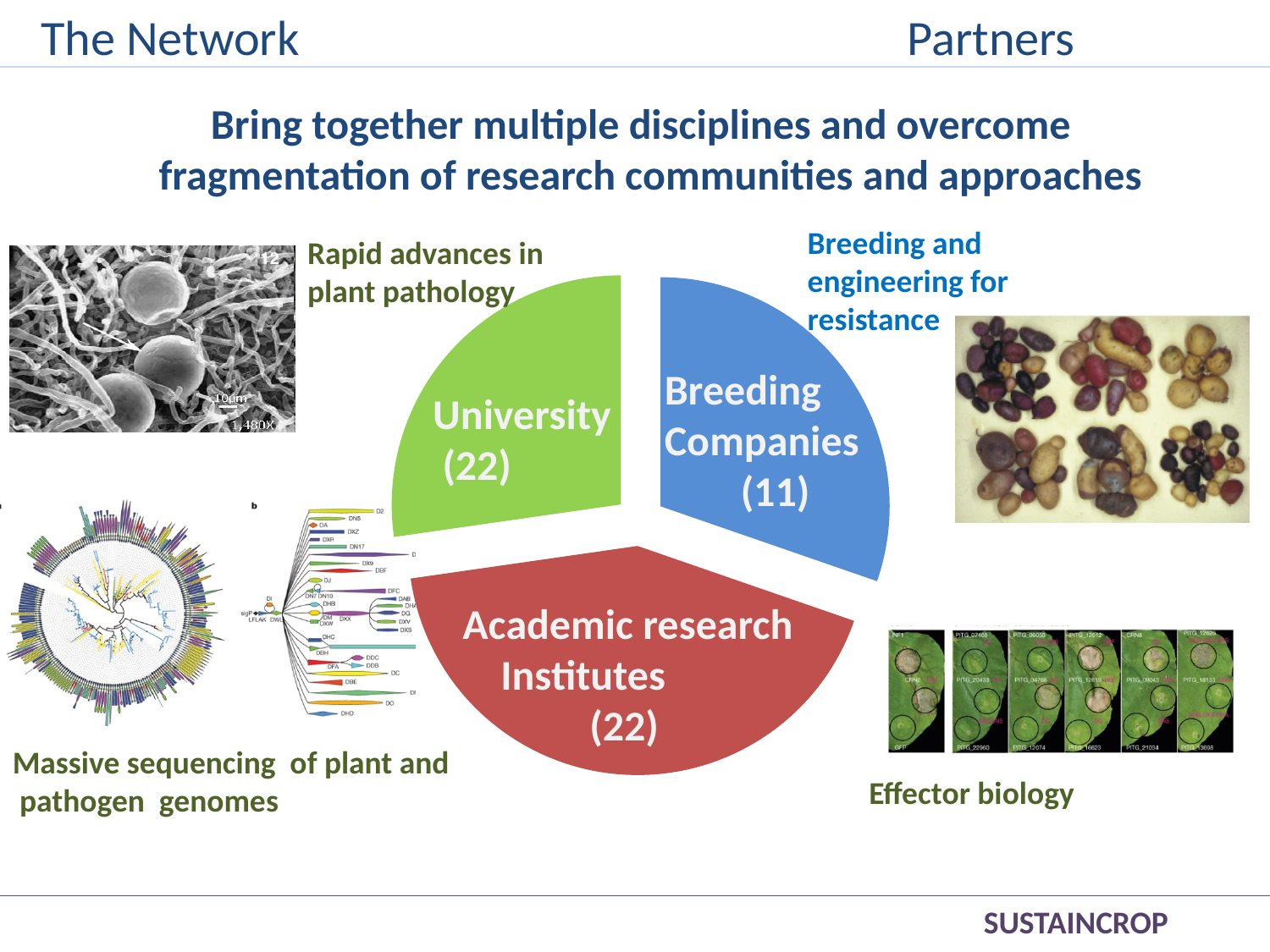
Which is larger, the value for Academic research Institutes or the value for Breeding Companies? Academic research Institutes What is the value shown for Academic research Institutes in the pie chart? 22 What kind of chart is shown on the slide? pie chart Which segment of the pie chart has the smallest value? Breeding Companies What share of the pie chart total does Breeding Companies represent? 20% What colour is the Academic research Institutes segment of the pie chart? red What is the difference between the University value and the Breeding Companies value? 11 What is the value shown for University in the pie chart? 22 What is the total of the three values shown in the pie chart? 55 What share of the pie chart total does University represent? 40% What is the value shown for Breeding Companies in the pie chart? 11 How many segments does the pie chart have? 3